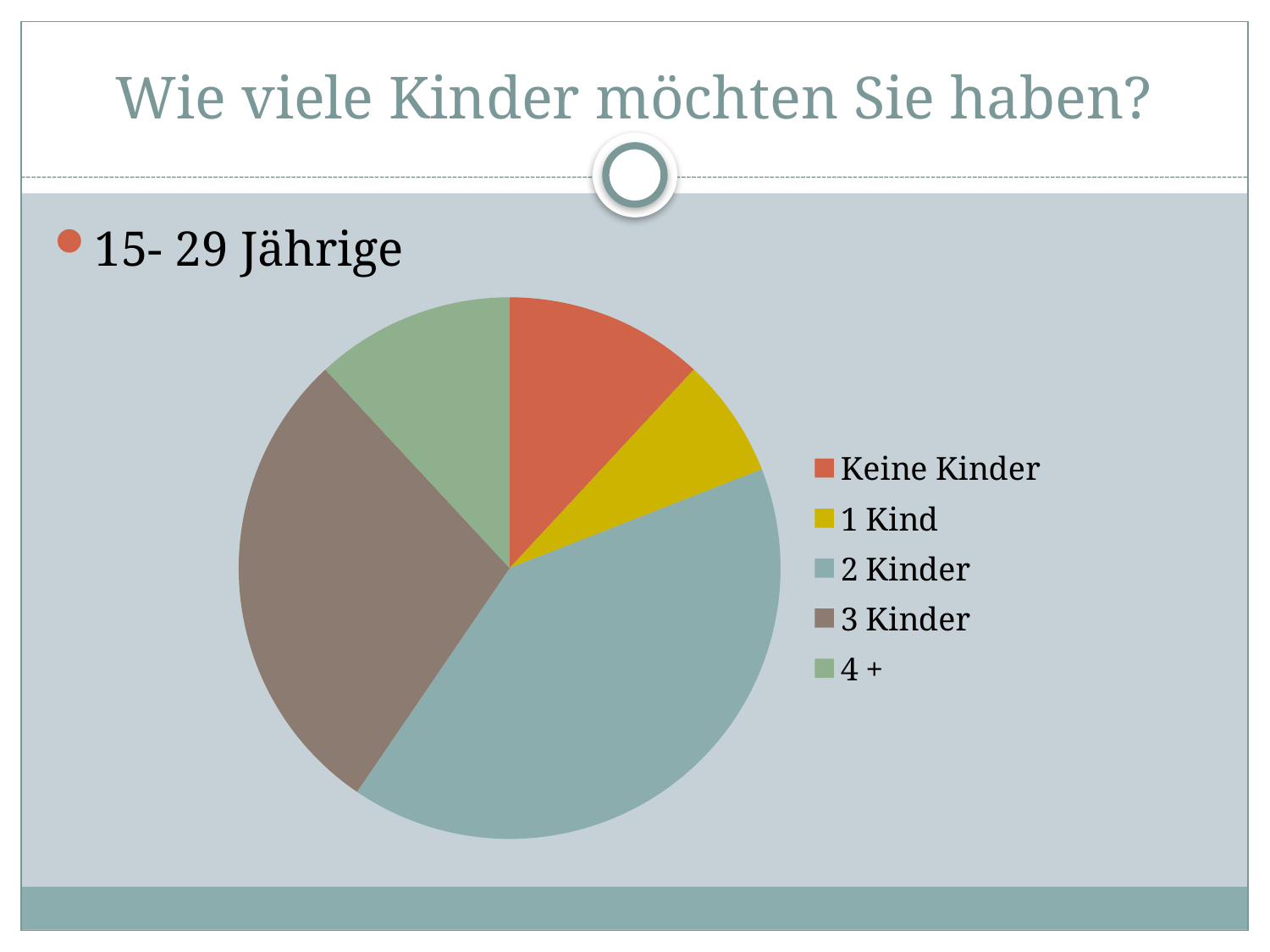
Which slice is larger, Keine Kinder or 1 Kind? Keine Kinder Which slice is larger, 2 Kinder or 3 Kinder? 2 Kinder Which category has the largest slice in the pie chart? 2 Kinder What is the title of the slide containing the pie chart? Wie viele Kinder möchten Sie haben? Which slice is larger, 3 Kinder or Keine Kinder? 3 Kinder What kind of chart is shown on the slide? pie chart Which age group does the pie chart refer to, according to the text above it? 15- 29 Jährige How many entries does the legend of the pie chart list? 5 Which category has the smallest slice in the pie chart? 1 Kind How many categories does the pie chart show? 5